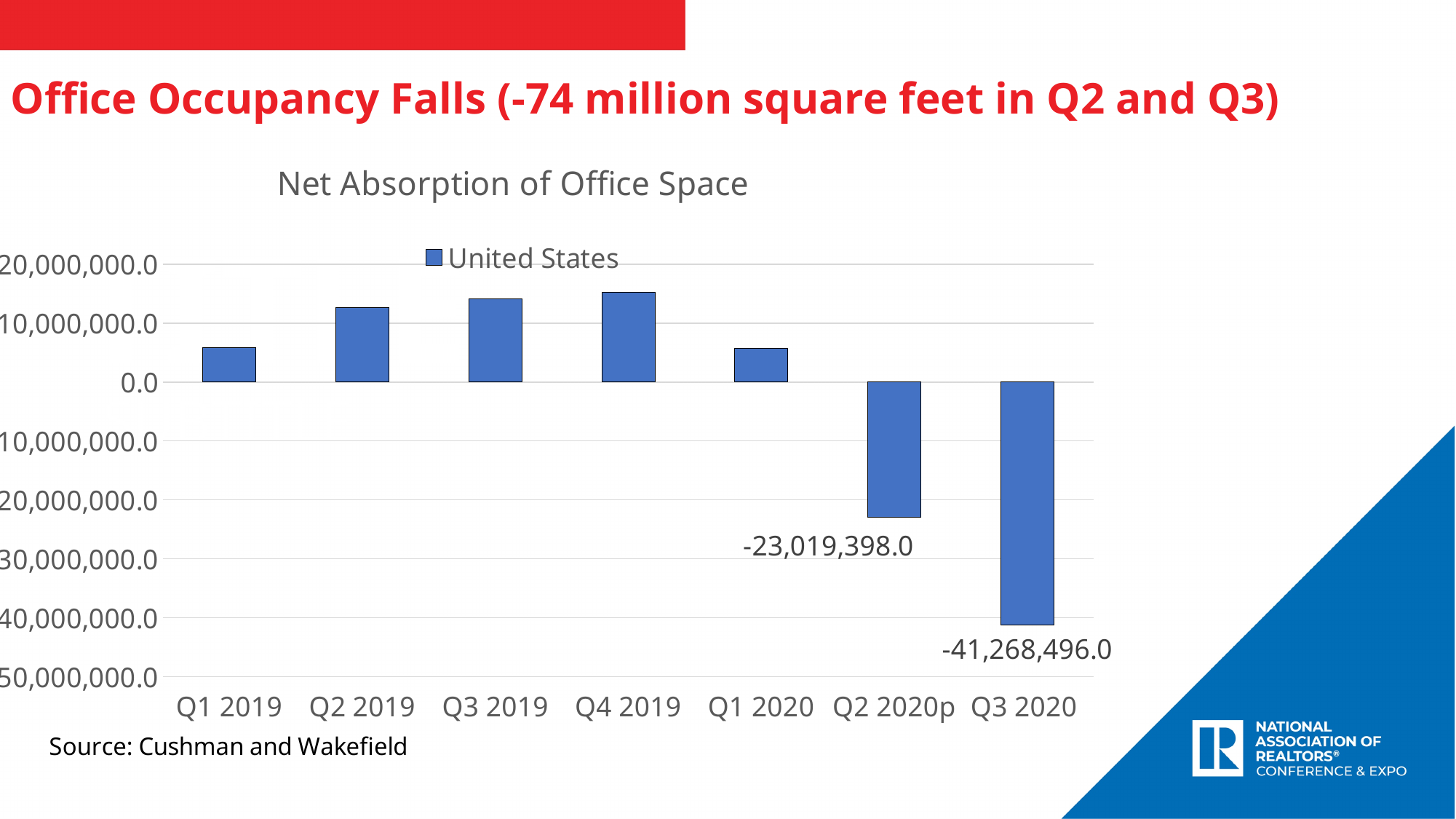
How many series does the legend list? 1 Which is larger, the value for Q1 2019 or Q2 2019? Q2 2019 What is the value for Q2 2020p? -23,019,398.0 What is the difference between the values for Q2 2020p and Q3 2020? 18,249,098.0 How many quarters are shown on the x axis? 7 Is the value for Q2 2019 greater or less than 10,000,000? greater Is the value for Q1 2020 greater or less than 10,000,000? less What is the value for Q3 2020? -41,268,496.0 Which quarter has the lowest net absorption? Q3 2020 Which quarter has the highest net absorption? Q4 2019 What kind of chart is this? bar chart From Q1 2019 to Q4 2019, do the values rise or fall? rise